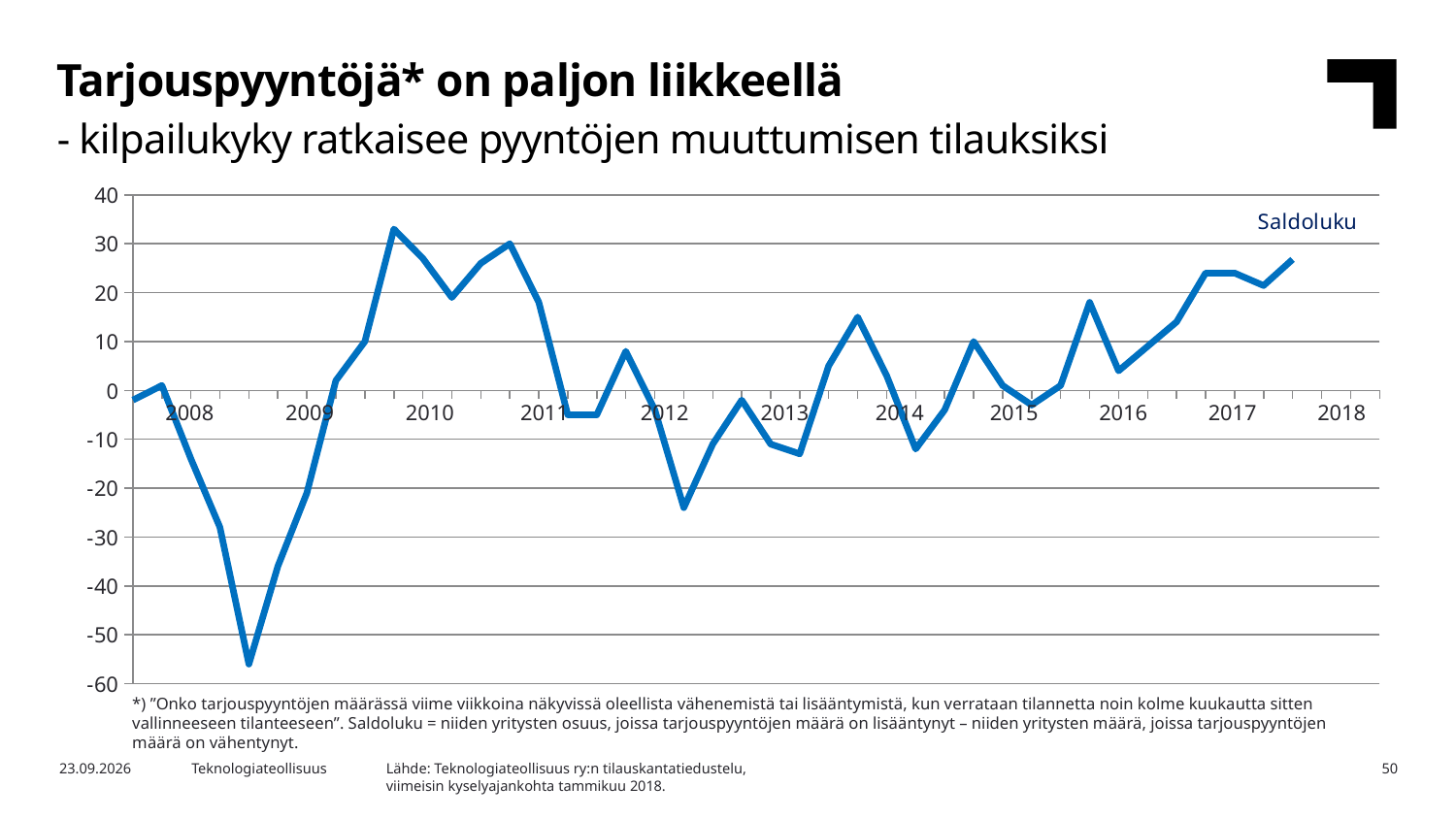
Is the lowest value reached by the line greater or less than -50? less Do the values rise or fall between the start of 2008 and the low point before 2009? fall Do the values rise or fall overall from 2016 to the end of the line? rise Is the value at the start of 2012 greater or less than -20? greater What are the lowest and highest values shown on the y axis? -60 and 40 What is the name of the series plotted on the chart? Saldoluku What kind of chart is shown on the slide? line chart Is the highest value reached by the line greater or less than 30? greater How many data series does the chart show? 1 How many year labels are shown on the x axis? 11